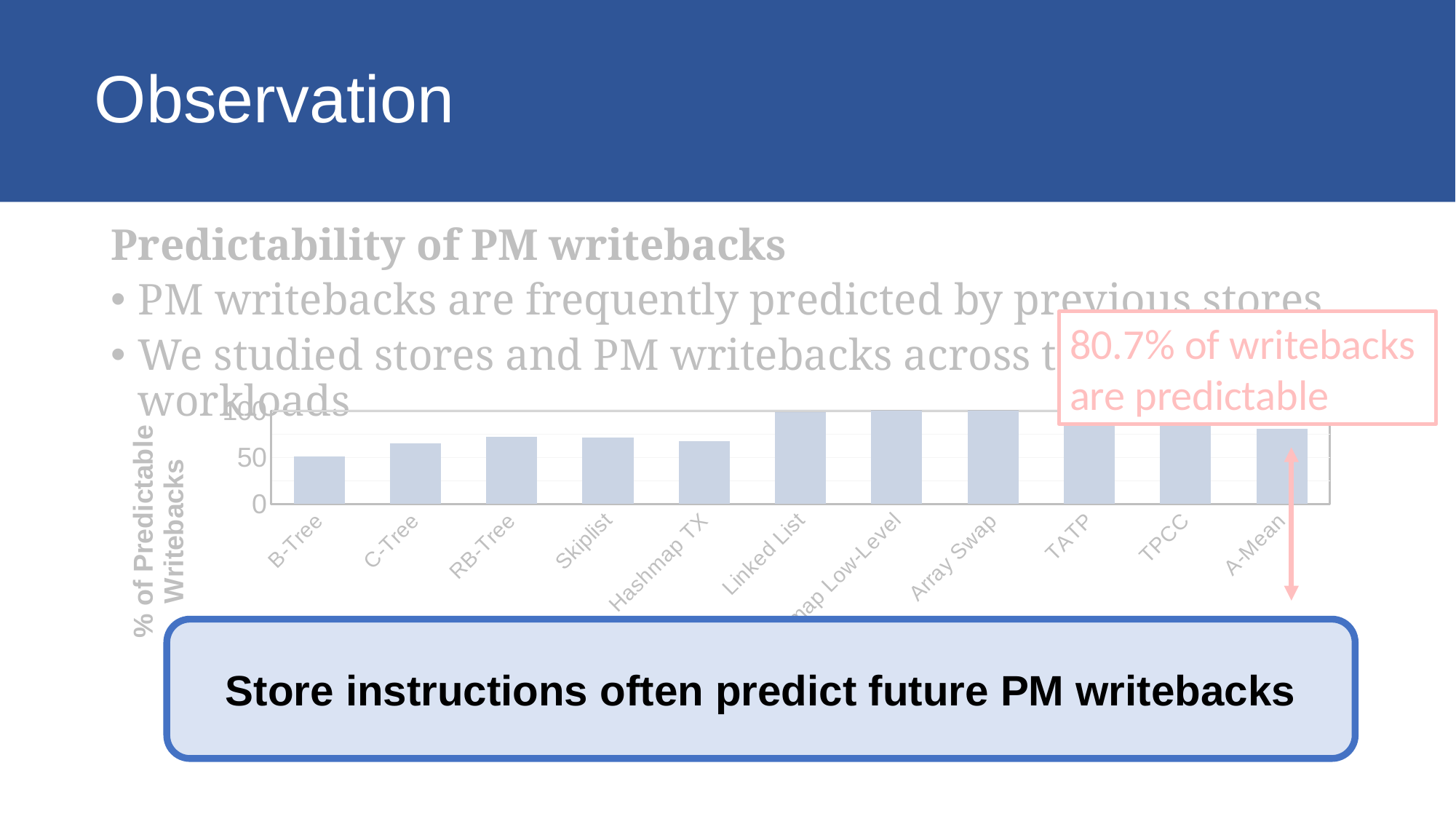
Which is larger, the value for Linked List or the value for B-Tree? Linked List According to the annotation on the chart, what percentage of writebacks are predictable for A-Mean? 80.7% Is the value for C-Tree greater or less than 50? greater Is the value for Skiplist greater or less than 100? less Which is larger, the value for RB-Tree or the value for B-Tree? RB-Tree What kind of chart is shown on the slide? bar chart Is the value for B-Tree greater or less than 100? less What is the highest tick value shown on the y axis? 100 How many categories are plotted along the x axis of the chart? 11 What is the label of the y axis of the chart? % of Predictable Writebacks Which category has the lowest percentage of predictable writebacks? B-Tree